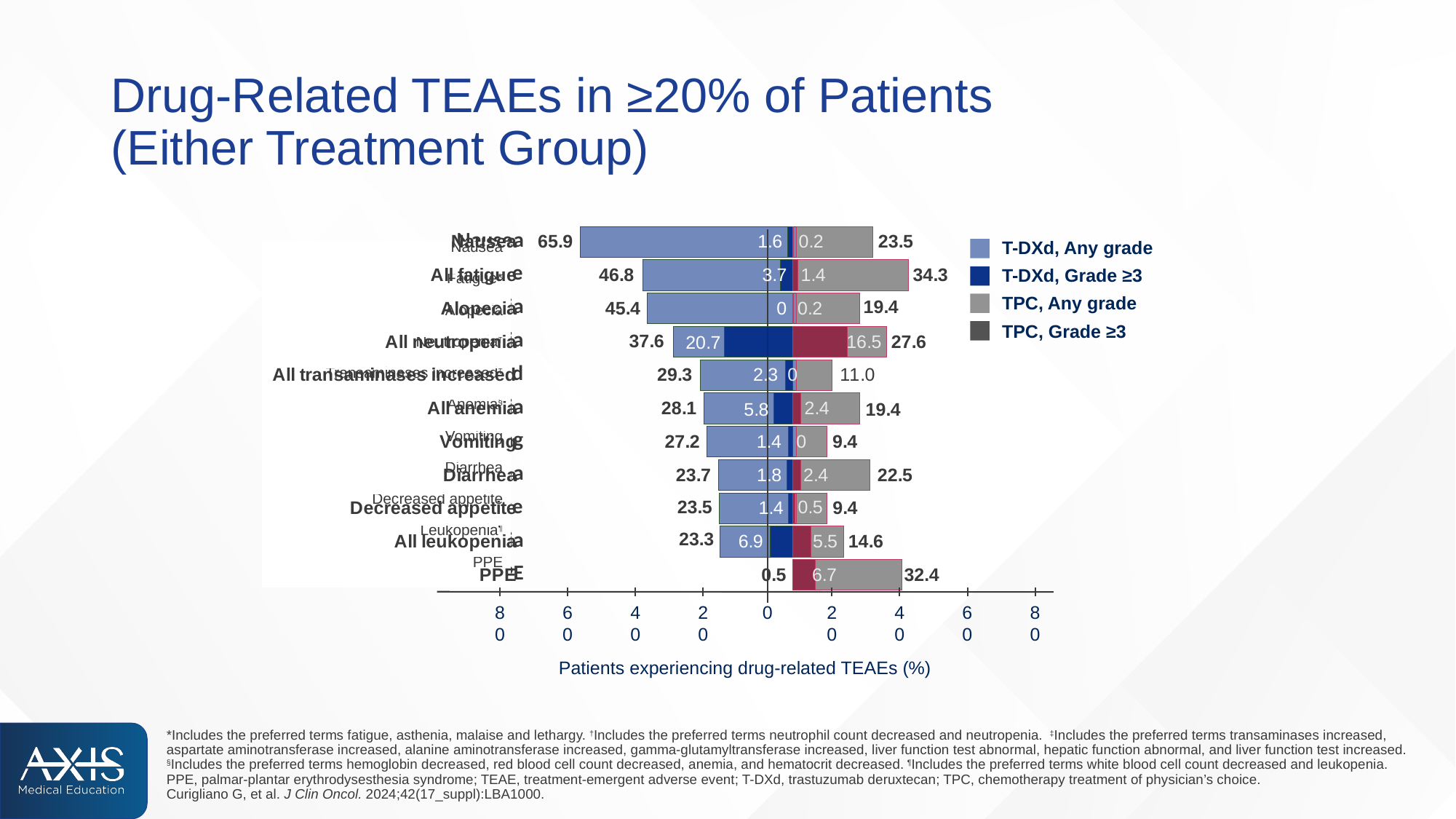
Which category has the highest T-DXd, Any grade value? Nausea What is the TPC, Any grade value for All fatigue? 34.3 What is the T-DXd, Grade ≥3 value for All neutropenia? 20.7 How many series does the legend list? 4 What type of chart is shown on the slide? bar chart What is the TPC, Grade ≥3 value for PPE? 6.7 Which is larger for Diarrhea: the T-DXd, Any grade value or the TPC, Any grade value? T-DXd, Any grade What is the T-DXd, Any grade value for Nausea? 65.9 How many adverse event categories are plotted on the chart? 11 What is the difference between the T-DXd, Any grade and TPC, Any grade values for Nausea? 42.4 Which category has the lowest T-DXd, Any grade value? PPE What is the label of the x axis? Patients experiencing drug-related TEAEs (%)